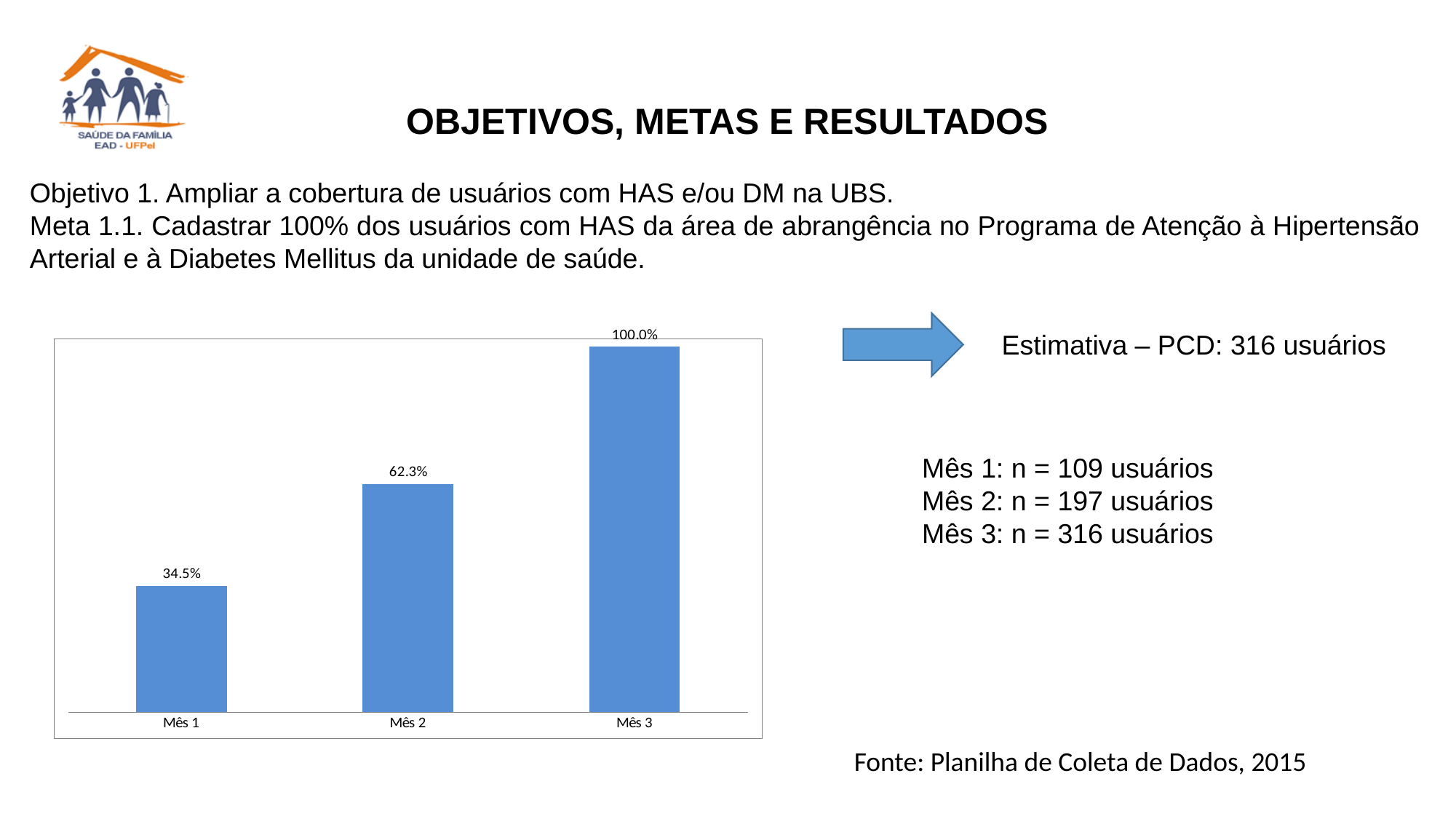
What is the difference between the values for Mês 2 and Mês 1? 27.8% What colour are the bars in the chart? Blue What kind of chart is shown on the slide? Bar chart What is the difference between the values for Mês 3 and Mês 1? 65.5% How many bars are shown in the chart? 3 Which month has the lowest value? Mês 1 What is the value for Mês 1? 34.5% What is the value for Mês 3? 100.0% What is the value for Mês 2? 62.3% Which month has the highest value? Mês 3 Do the values rise or fall from Mês 1 to Mês 3? Rise Which is larger, the value for Mês 2 or the value for Mês 1? Mês 2